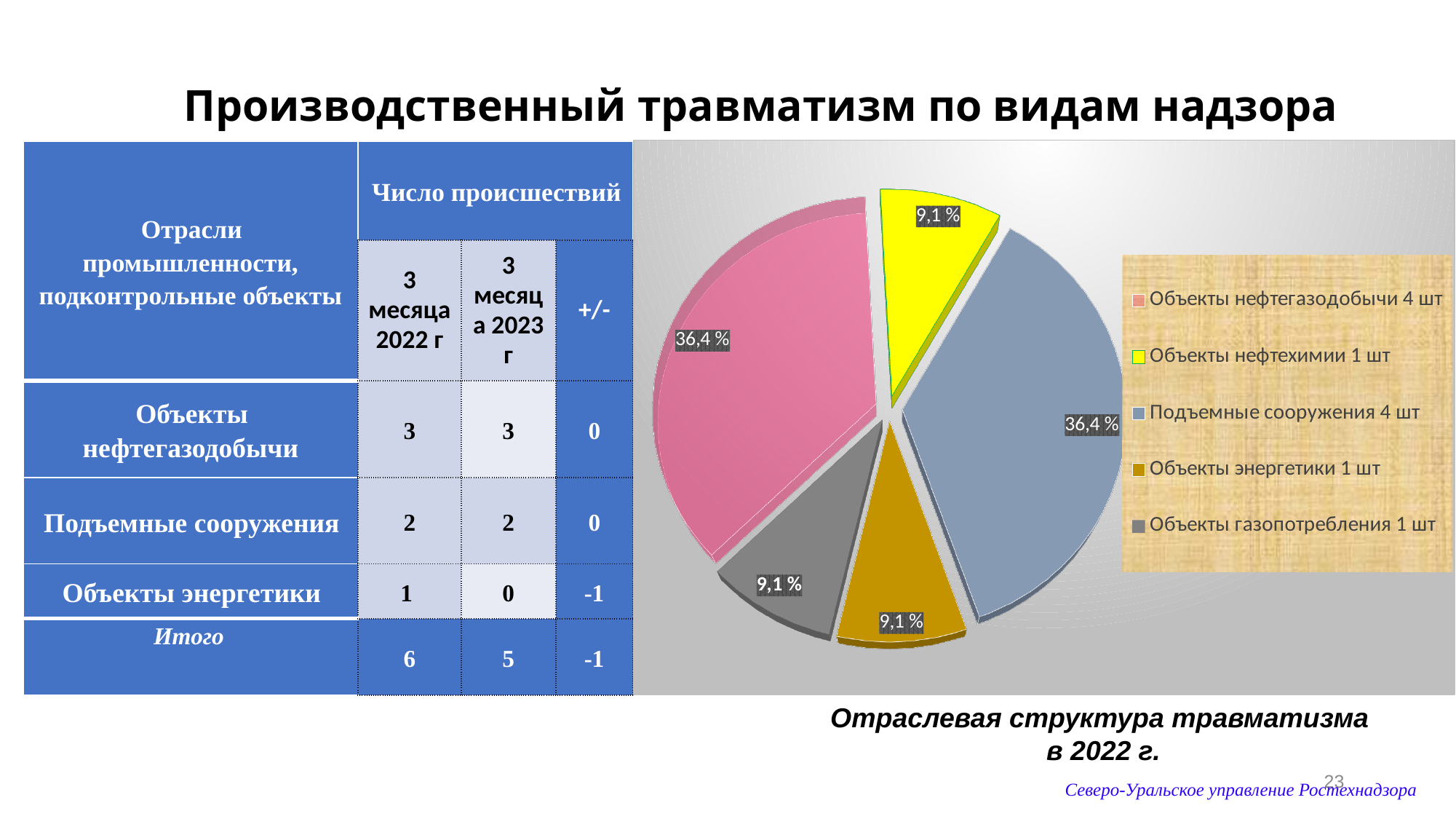
What share of the pie does the slice for Подъемные сооружения have? 36,4 % How many entries does the pie chart's legend list? 5 What share of the pie does the slice for Объекты нефтехимии have? 9,1 % What share of the pie does the slice for Объекты газопотребления have? 9,1 % What colour is the slice for Объекты нефтехимии in the pie chart? Yellow How many slices does the pie chart have? 5 What is the difference in percentage points between the Подъемные сооружения slice and the Объекты энергетики slice? 27,3 What kind of chart is shown on the right side of the slide? Pie chart What is the caption below the pie chart? Отраслевая структура травматизма в 2022 г. According to the legend, how many incidents (шт) are attributed to Объекты нефтегазодобычи? 4 шт Which is larger in the pie chart: the slice for Объекты нефтегазодобычи or the slice for Объекты нефтехимии? Объекты нефтегазодобычи